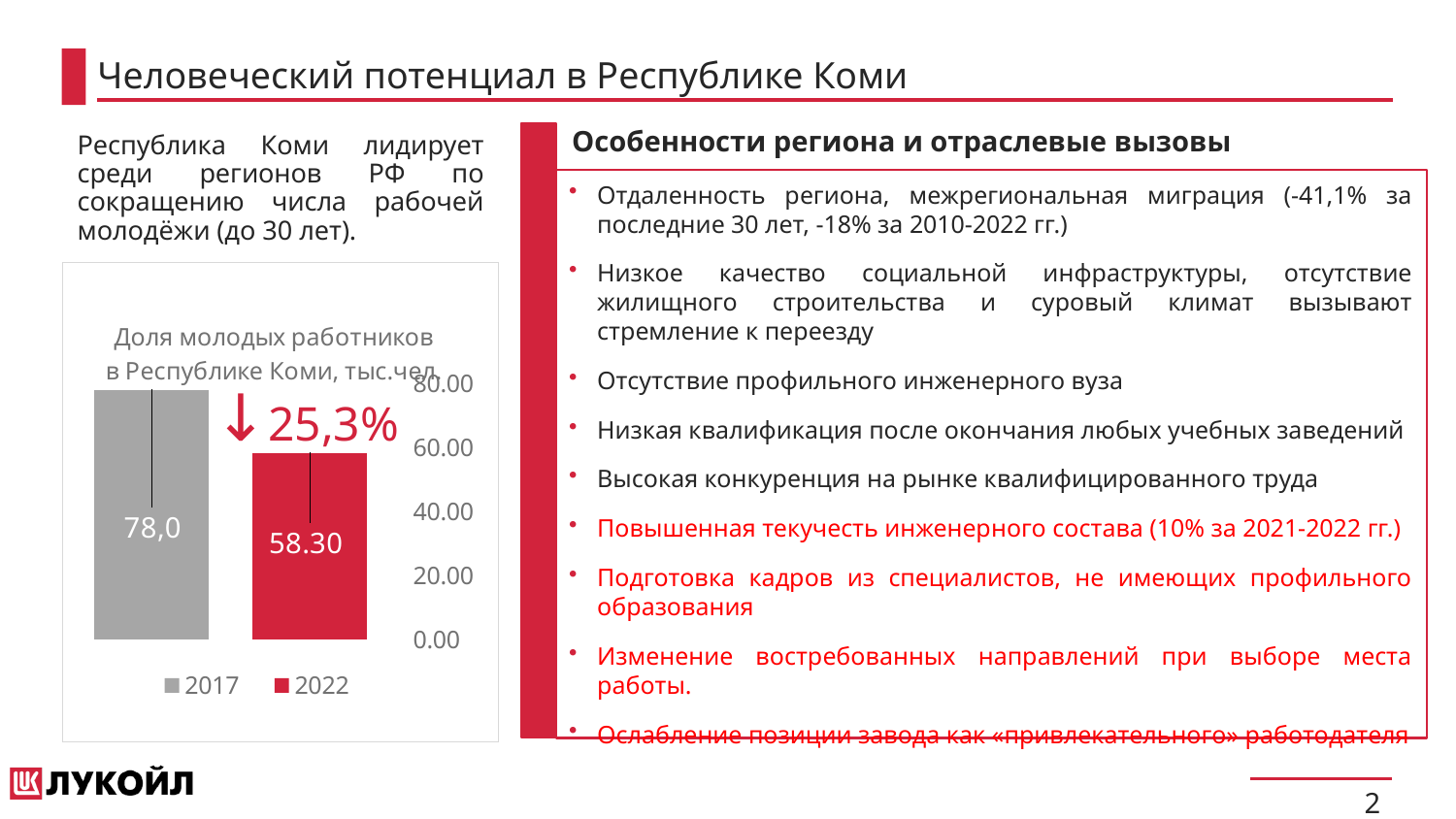
By how much does the 2017 value exceed the 2022 value in the chart 'Доля молодых работников в Республике Коми, тыс.чел'? 19.7 Is the value for 2017 larger or smaller than the value for 2022 in the chart 'Доля молодых работников в Республике Коми, тыс.чел'? larger What is the value for 2022 in the chart 'Доля молодых работников в Республике Коми, тыс.чел'? 58.30 Is the value for 2017 greater or less than 60.00 in the chart 'Доля молодых работников в Республике Коми, тыс.чел'? greater How many bars are plotted in the chart 'Доля молодых работников в Республике Коми, тыс.чел'? 2 What is the value for 2017 in the chart 'Доля молодых работников в Республике Коми, тыс.чел'? 78,0 How many entries does the legend of the chart 'Доля молодых работников в Республике Коми, тыс.чел' list? 2 What kind of chart is 'Доля молодых работников в Республике Коми, тыс.чел'? bar chart Which year has the higher value in the chart 'Доля молодых работников в Республике Коми, тыс.чел'? 2017 Is the value for 2022 greater or less than 60.00 in the chart 'Доля молодых работников в Республике Коми, тыс.чел'? less Which year has the lower value in the chart 'Доля молодых работников в Республике Коми, тыс.чел'? 2022 What percentage decrease is shown next to the arrow on the chart 'Доля молодых работников в Республике Коми, тыс.чел'? 25,3%